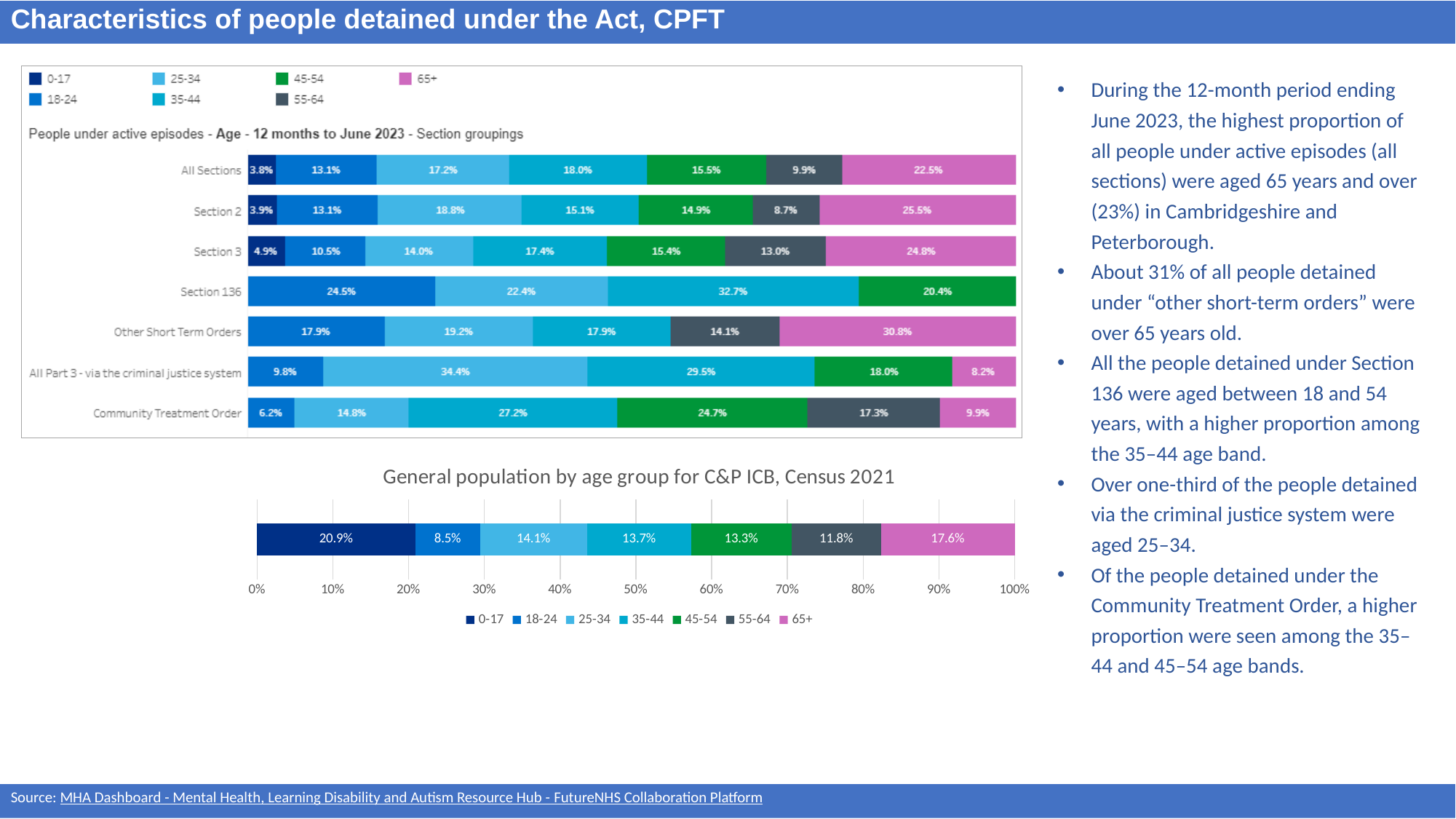
In the bottom chart (General population by age group for C&P ICB, Census 2021), what percentage of the population is aged 0-17? 20.9% In the top chart (People under active episodes - Age), what percentage of people under Section 136 were aged 35-44? 32.7% In the top chart (People under active episodes - Age), what percentage of people under All Sections were aged 65+? 22.5% In the top chart (People under active episodes - Age), how many section groupings are shown? 7 In the top chart (People under active episodes - Age), which age band has the largest share for Other Short Term Orders? 65+ In the top chart (People under active episodes - Age), which is larger for All Part 3 - via the criminal justice system: the 25-34 share or the 35-44 share? 25-34 In the top chart (People under active episodes - Age), what percentage of people under Community Treatment Order were aged 45-54? 24.7% What type of chart is the bottom chart (General population by age group for C&P ICB, Census 2021)? Stacked bar chart In the bottom chart (General population by age group for C&P ICB, Census 2021), how many age groups does the legend list? 7 In the top chart (People under active episodes - Age), what is the difference between the 65+ share for Section 2 and the 65+ share for All Sections? 3.0% In the bottom chart (General population by age group for C&P ICB, Census 2021), which age group has the smallest share? 18-24 In the top chart (People under active episodes - Age), which age band has the smallest share for Section 3? 0-17